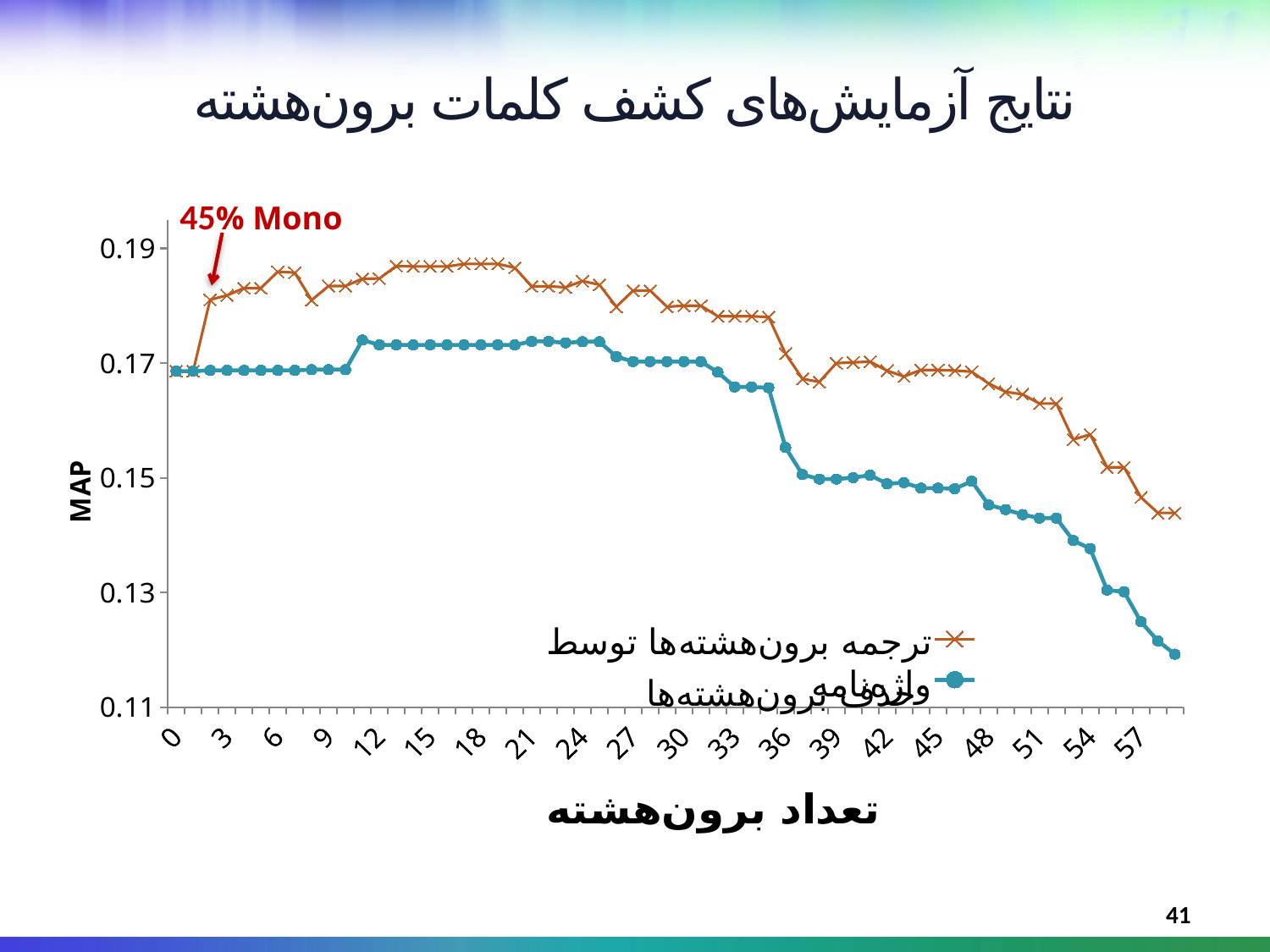
Is the value of the orange x-marker series at x = 18 greater or less than 0.17? greater Does the blue circle-marker series (حذف برون‌هشته‌ها) rise or fall overall as the number of OOV words increases from 36 to 57? fall At x = 18, which series has the higher MAP value: the orange x-marker series or the blue circle-marker series? the orange x-marker series (ترجمه برون‌هشته‌ها توسط واژه‌نامه) Does the orange x-marker series rise or fall overall between x = 36 and x = 57? fall Is the value of the orange x-marker series at x = 57 greater or less than 0.15? less What text does the red annotation with the arrow show? 45% Mono Is the value of the blue circle-marker series (حذف برون‌هشته‌ها) at x = 57 greater or less than 0.13? less What is the label of the vertical axis? MAP What kind of chart is shown on the slide? line chart How many series does the legend list? 2